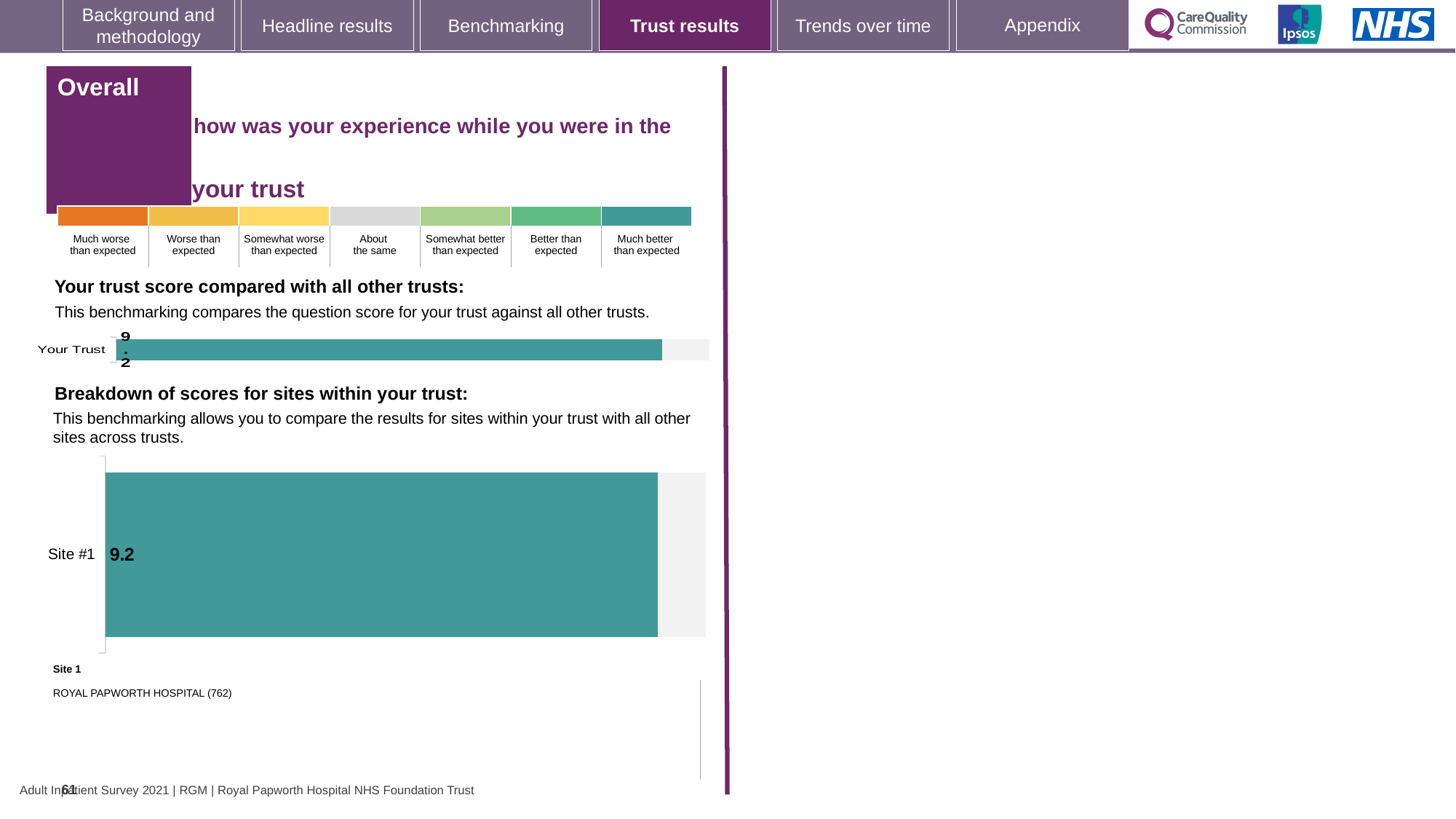
Is the score for Site #1 in the 'Breakdown of scores for sites within your trust' chart greater or less than 5? greater What kind of chart is the 'Your trust score compared with all other trusts' chart? Bar chart In the 'Breakdown of scores for sites within your trust' chart, what is the label of the only bar? Site #1 What kind of chart is the 'Breakdown of scores for sites within your trust' chart? Bar chart How many sites are plotted in the 'Breakdown of scores for sites within your trust' chart? 1 Which hospital is listed as Site 1 below the 'Breakdown of scores for sites within your trust' chart? ROYAL PAPWORTH HOSPITAL (762) In the 'Your trust score compared with all other trusts' chart, what is the score for Your Trust? 9.2 According to the colour key, which category does the teal colour of the Site #1 bar represent? Much better than expected How many bars are plotted in the 'Your trust score compared with all other trusts' chart? 1 In the 'Breakdown of scores for sites within your trust' chart, what is the score for Site #1? 9.2